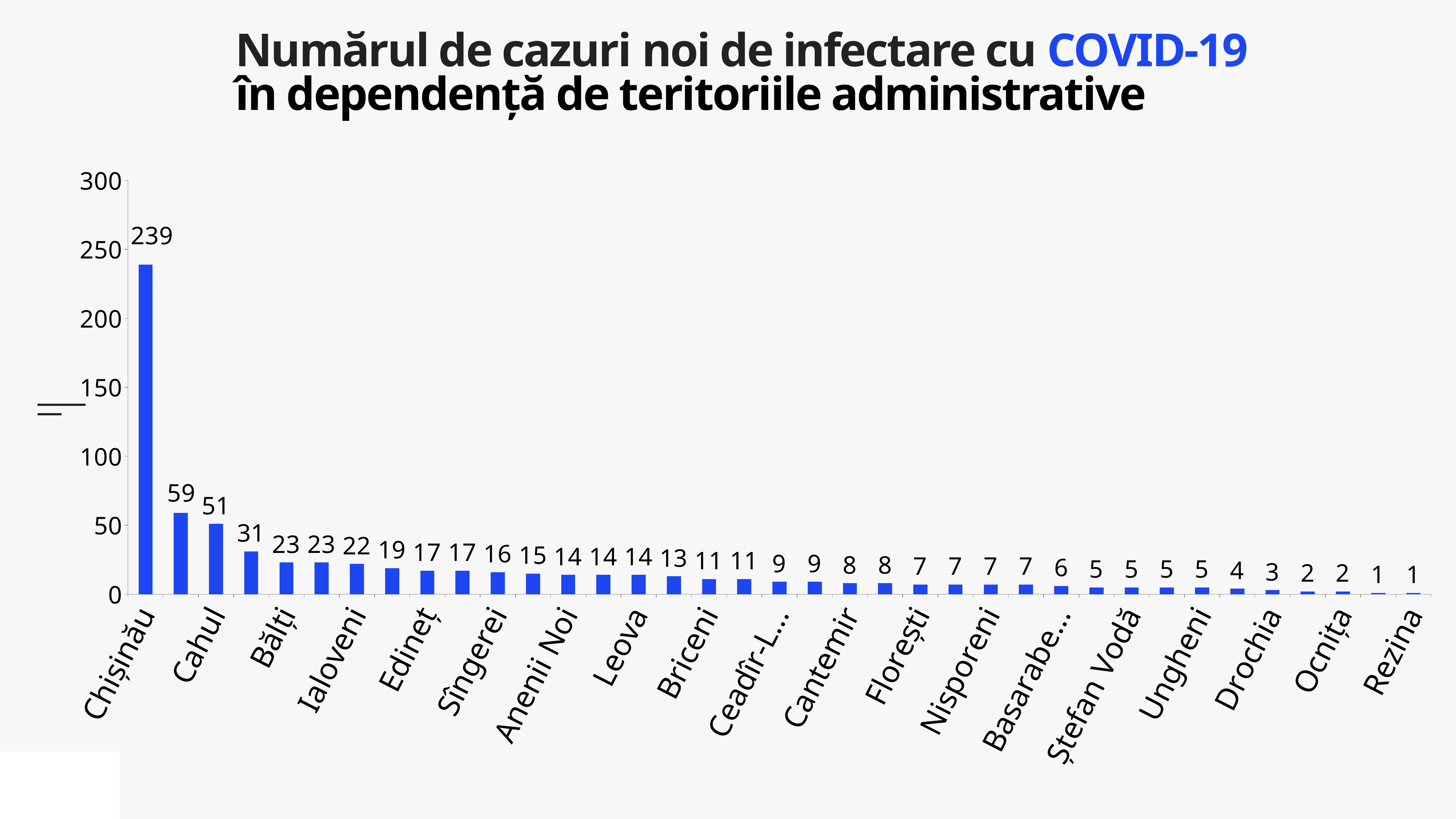
What is the lowest value shown on the chart? 1 Is the value for Cahul greater or less than 100? less Is the value for Chișinău greater or less than 200? greater Which has more new cases, Cahul or Rezina? Cahul What type of chart is shown on the slide? bar chart What is the number of new cases for Rezina? 1 Which has more new cases, Chișinău or Cahul? Chișinău What is the number of new cases for Chișinău? 239 How many bars are plotted on the chart? 37 Which territory has the highest number of new COVID-19 cases? Chișinău What is the difference between the highest bar (239) and the second highest bar (59)? 180 Do the values rise or fall from left to right along the x axis? fall